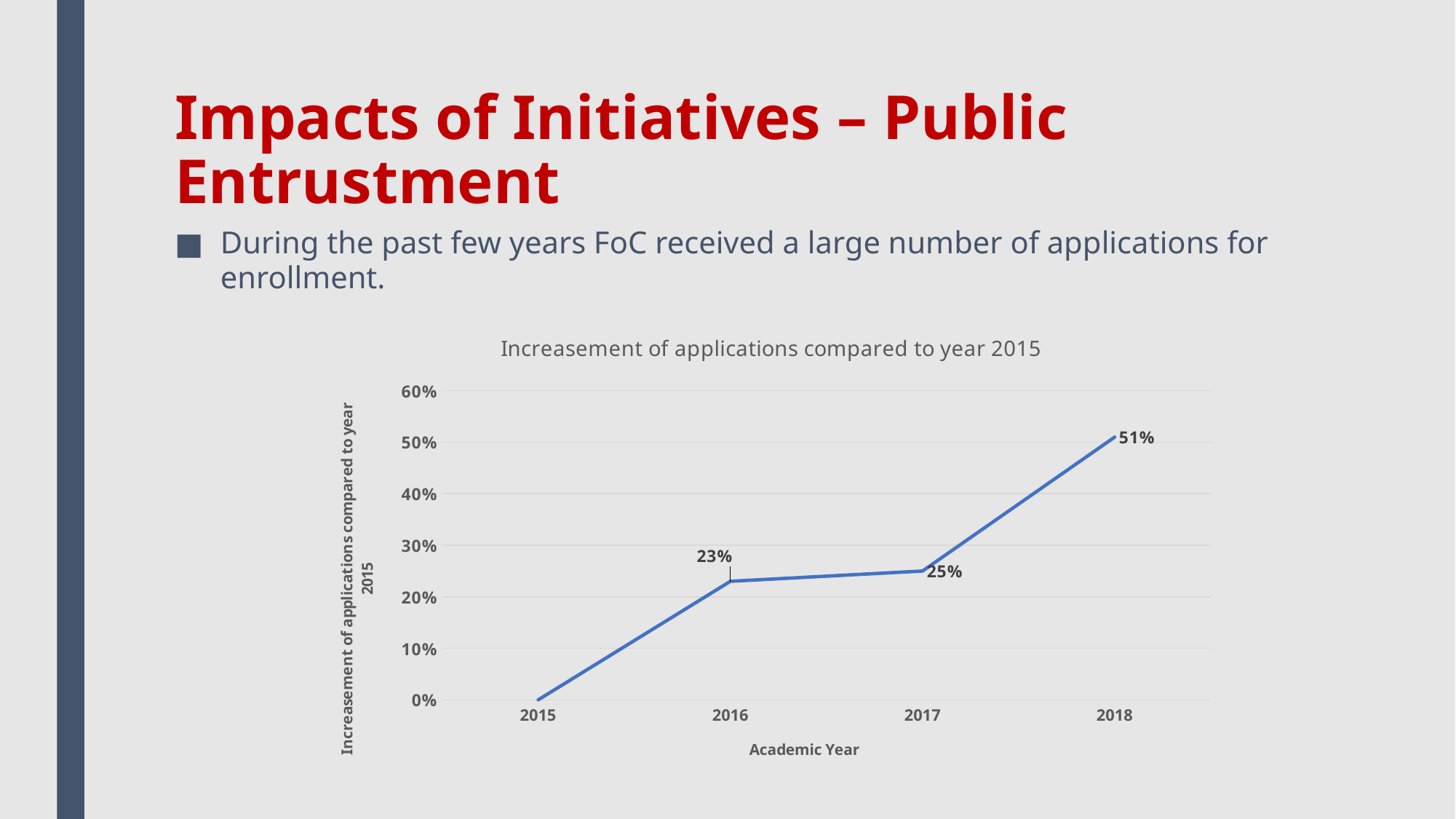
Do the values rise or fall from 2015 to 2018? rise What is the value for 2016? 23% What is the difference between the values for 2018 and 2017? 26% Which is larger, the value for 2016 or the value for 2018? 2018 What kind of chart is shown? line chart What is the value for 2015? 0% What is the value for 2018? 51% How many years are plotted on the x axis? 4 Which year has the highest value? 2018 What is the difference between the values for 2017 and 2016? 2% Which year has the lowest value? 2015 What is the value for 2017? 25%